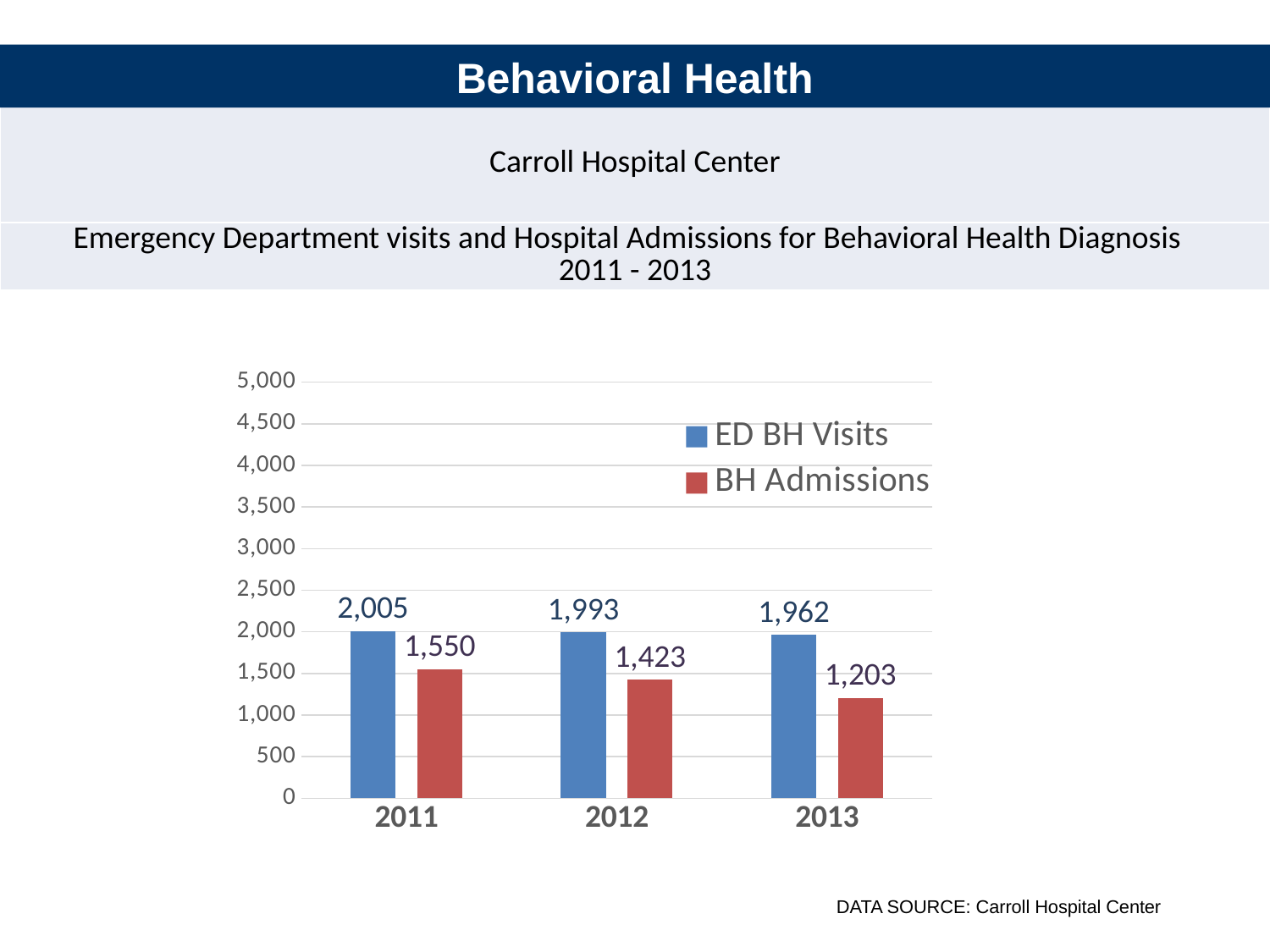
What is the difference between BH Admissions in 2011 and in 2013? 347 What is the difference between ED BH Visits and BH Admissions in 2013? 759 Which is larger in 2012, ED BH Visits or BH Admissions? ED BH Visits Which year has the highest value for BH Admissions? 2011 How many series does the legend list? 2 How many years are shown on the x axis? 3 What is the value for ED BH Visits in 2011? 2,005 Is the value for BH Admissions in 2011 greater or less than 2,000? less What is the value for BH Admissions in 2012? 1,423 Which year has the lowest value for ED BH Visits? 2013 Do the BH Admissions values rise or fall from 2011 to 2013? fall What is the value for BH Admissions in 2013? 1,203